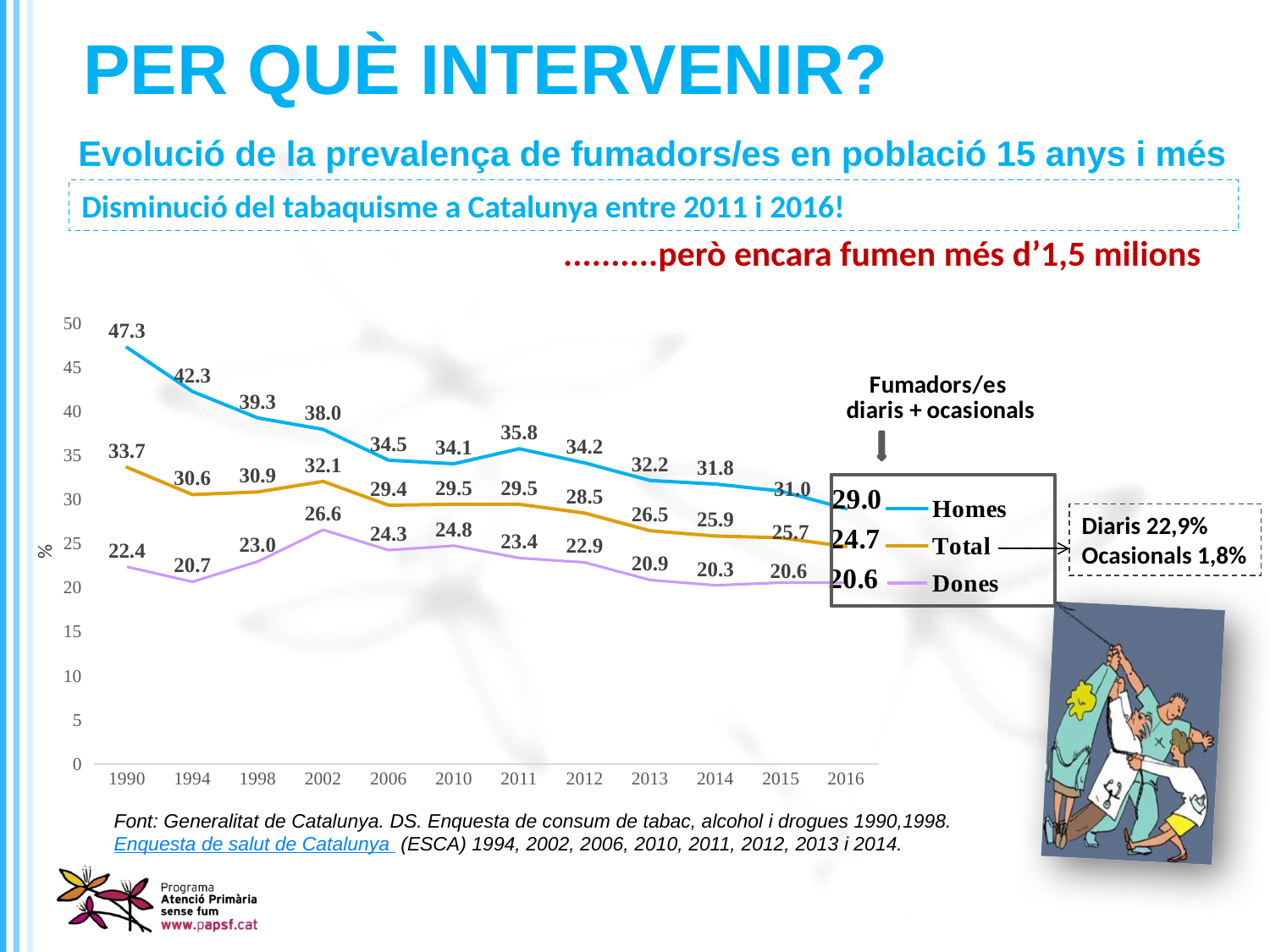
What is the difference between the Homes value in 1990 and the Homes value in 2016? 18.3 Does the Homes series generally rise or fall from 1990 to 2016? Fall How many series does the legend list? 3 How many years are plotted along the x axis? 12 What is the value for Dones in 2002? 26.6 Which series is drawn in purple? Dones Which is larger, the Total value in 2011 or the Total value in 2013? 2011 What kind of chart is shown on the slide? Line chart What is the value for Homes in 1990? 47.3 In which year is the Dones series at its highest? 2002 In which year is the Homes series at its lowest? 2016 What is the value for Total in 2016? 24.7